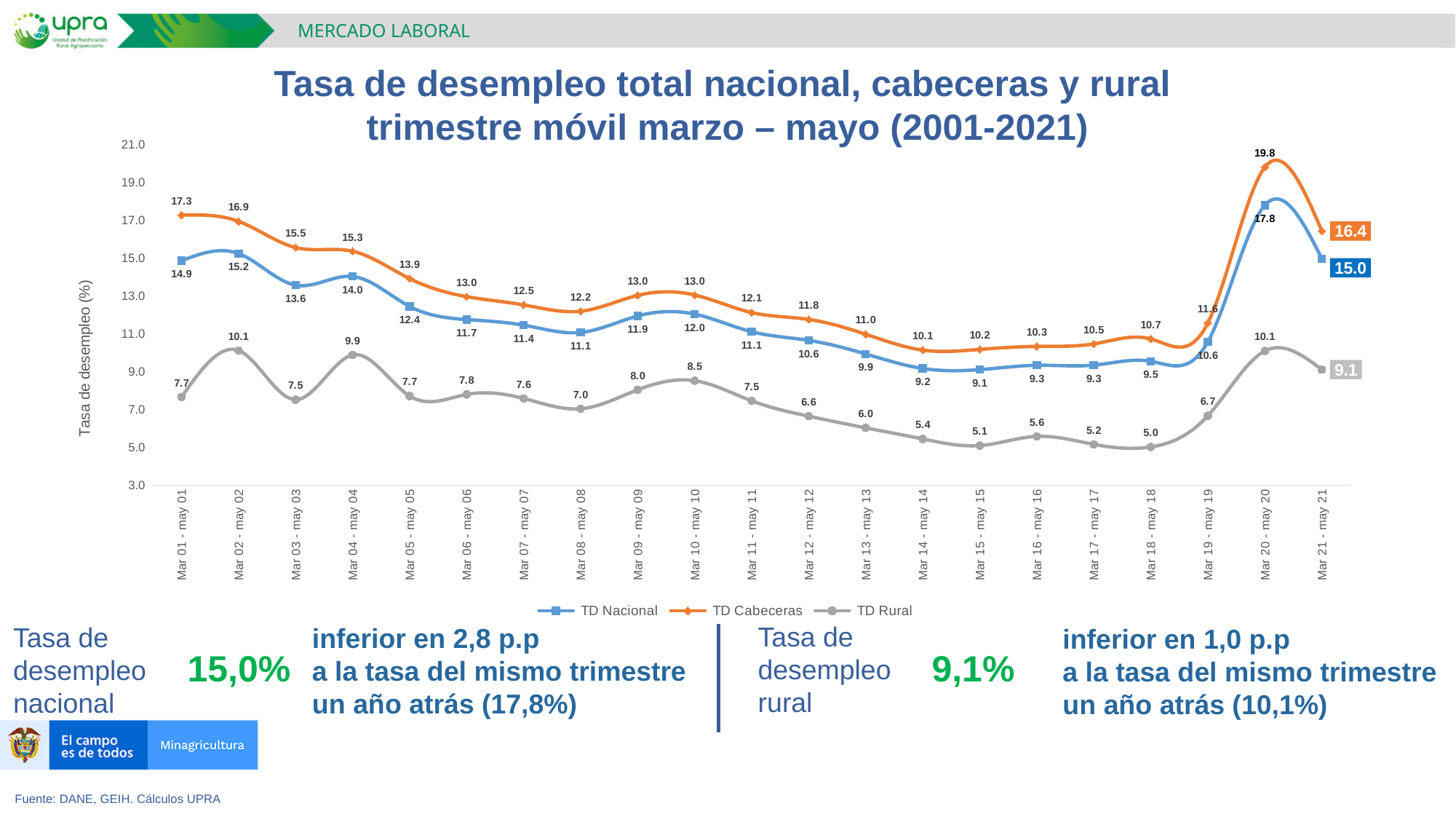
In which period does TD Nacional reach its lowest value? Mar 15 - may 15 How many periods are plotted along the x axis? 21 By how much did TD Nacional fall from Mar 20 - may 20 to Mar 21 - may 21? 2.8 Which is larger for TD Nacional: the value for Mar 01 - may 01 or for Mar 02 - may 02? Mar 02 - may 02 In which period does TD Cabeceras reach its highest value? Mar 20 - may 20 What is the value of TD Cabeceras for Mar 20 - may 20? 19.8 Does TD Rural rise or fall from Mar 10 - may 10 to Mar 15 - may 15? Fall What is the value of TD Rural for Mar 18 - may 18? 5.0 What is the difference between TD Cabeceras and TD Rural for Mar 21 - may 21? 7.3 How many series does the legend list? 3 What kind of chart is shown on the slide? Line chart What is the value of TD Nacional for Mar 21 - may 21? 15.0